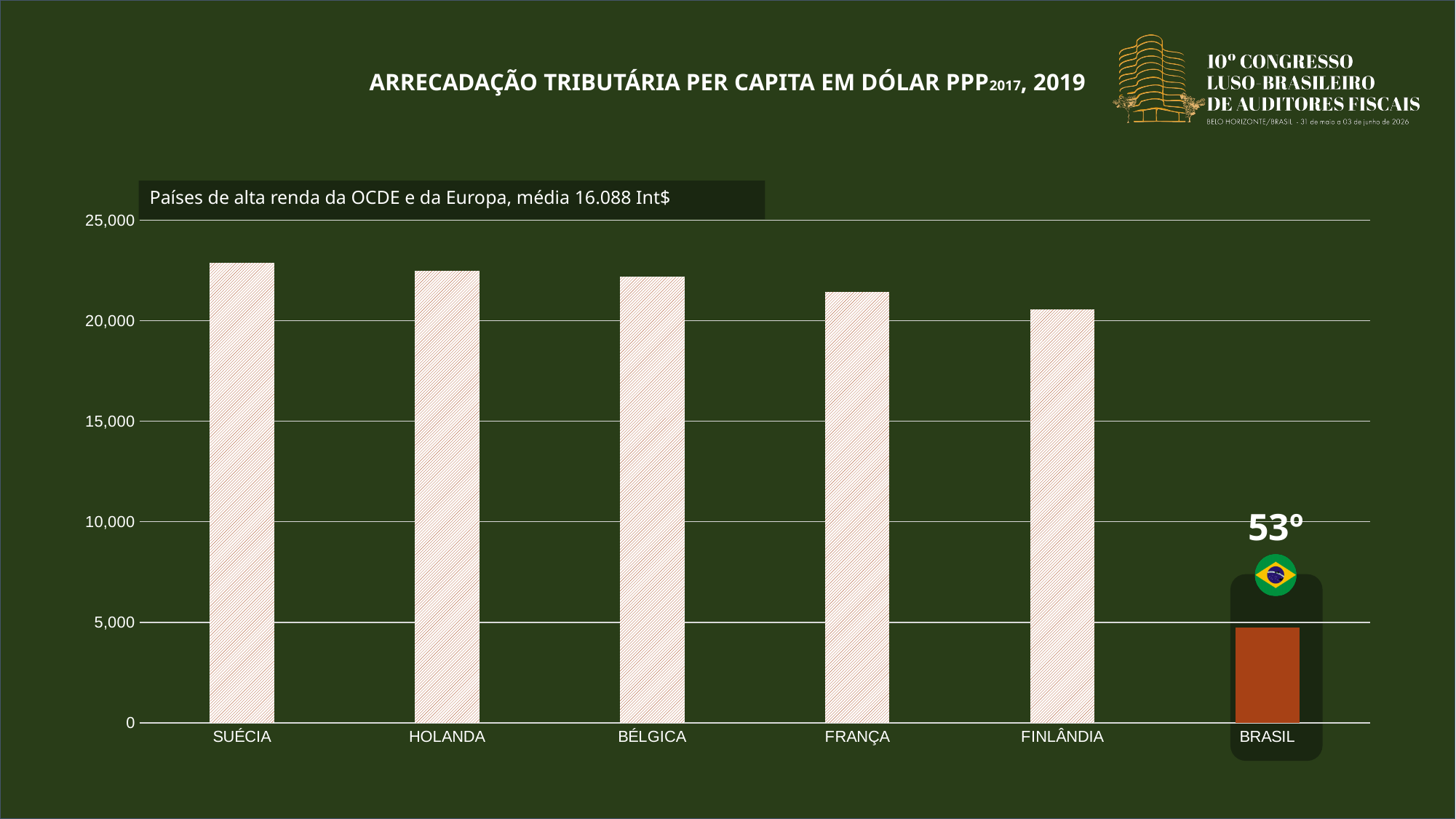
Is the value for França greater or less than 20,000? greater What average value is stated in the text box above the chart for high-income OECD and European countries? 16.088 Int$ Is the value for Brasil greater or less than 5,000? less Which is larger, the value for Suécia or the value for Finlândia? Suécia Which country has the lowest tax revenue per capita in the chart? Brasil Do the values rise or fall from left to right along the x axis? fall Which country has the highest tax revenue per capita in the chart? Suécia How many countries are shown on the x axis of the chart? 6 What is the title of the chart? ARRECADAÇÃO TRIBUTÁRIA PER CAPITA EM DÓLAR PPP2017, 2019 What kind of chart is shown on the slide? bar chart Is the value for Finlândia greater or less than 20,000? greater